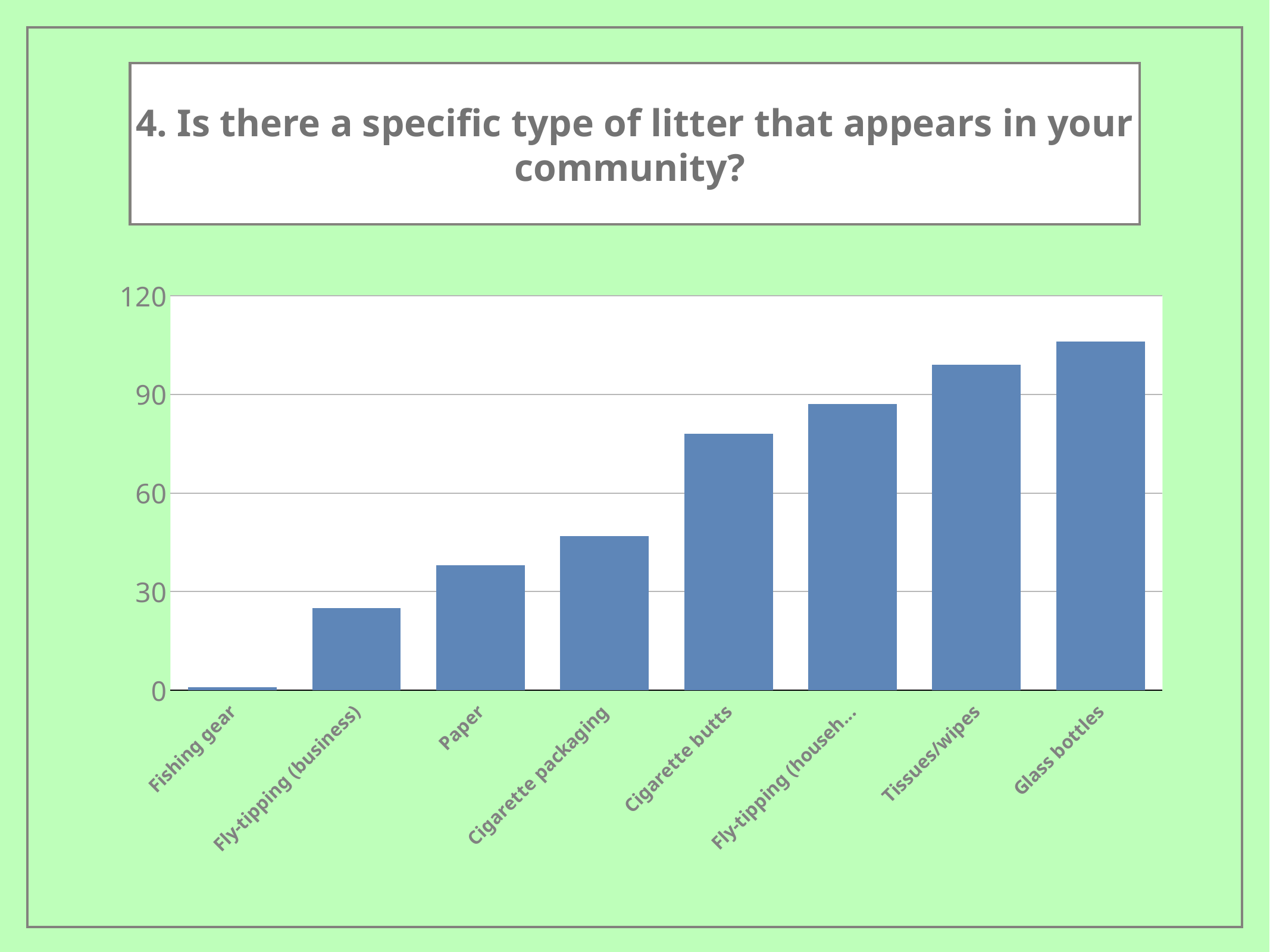
Is the value for Fly-tipping (business) greater or less than 30? less Is the value for Glass bottles greater or less than 90? greater Is the value for Cigarette butts greater or less than 60? greater Which is larger, the value for Fly-tipping (business) or the value for Cigarette packaging? Cigarette packaging What kind of chart is shown on the slide? bar chart Which category has the highest value? Glass bottles Which category has the lowest value? Fishing gear How many categories are shown on the x axis? 8 Which is larger, the value for Paper or the value for Cigarette butts? Cigarette butts What is the title of the chart? 4. Is there a specific type of litter that appears in your community? Do the values rise or fall from left to right along the x axis? rise